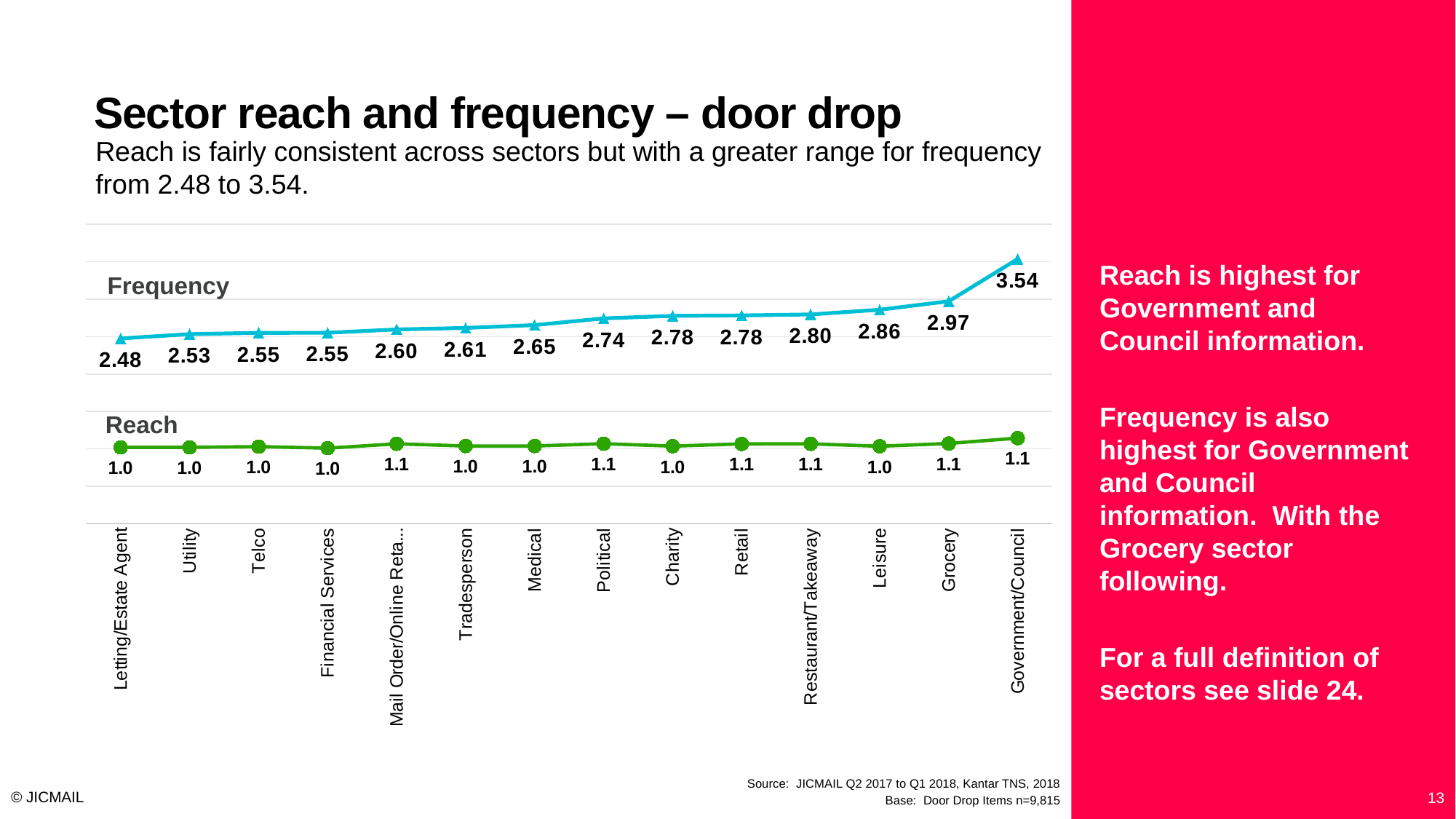
What type of chart is shown on the slide? Line chart What is the Frequency value for Political? 2.74 How many data series does the chart show? 2 Which has a higher Frequency, Leisure or Medical? Leisure What is the Reach value for Retail? 1.1 What is the Frequency value for Restaurant/Takeaway? 2.80 Which sector has the highest Frequency? Government/Council Which sector has the lowest Frequency? Letting/Estate Agent What is the difference in Frequency between Government/Council and Grocery? 0.57 What is the Frequency value for Grocery? 2.97 How many sectors are plotted on the chart? 14 Does the Frequency line rise or fall from left to right across the sectors? Rise